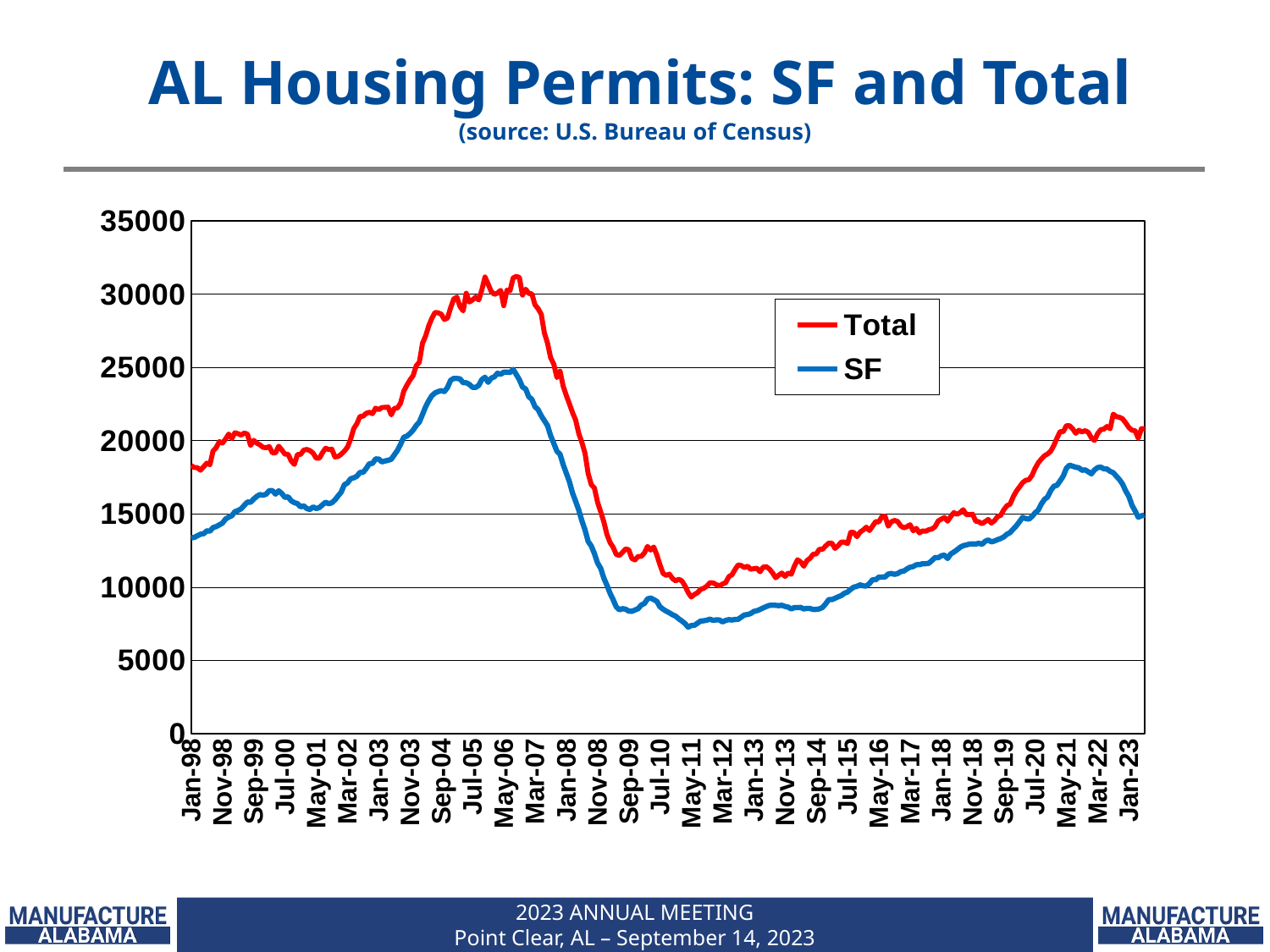
What is the title of the chart? AL Housing Permits: SF and Total Which colour is used for the Total series? red Do the Total values rise or fall between May-06 and May-11? fall Is the value for Total at Jan-98 greater or less than 15000? greater Which series is higher at Jan-08, Total or SF? Total How many series does the legend list? 2 Is the value for SF at Jan-98 greater or less than 15000? less Is the value for Total at May-06 greater or less than 25000? greater What kind of chart is shown on the slide? line chart Do the SF values rise or fall between May-11 and May-21? rise